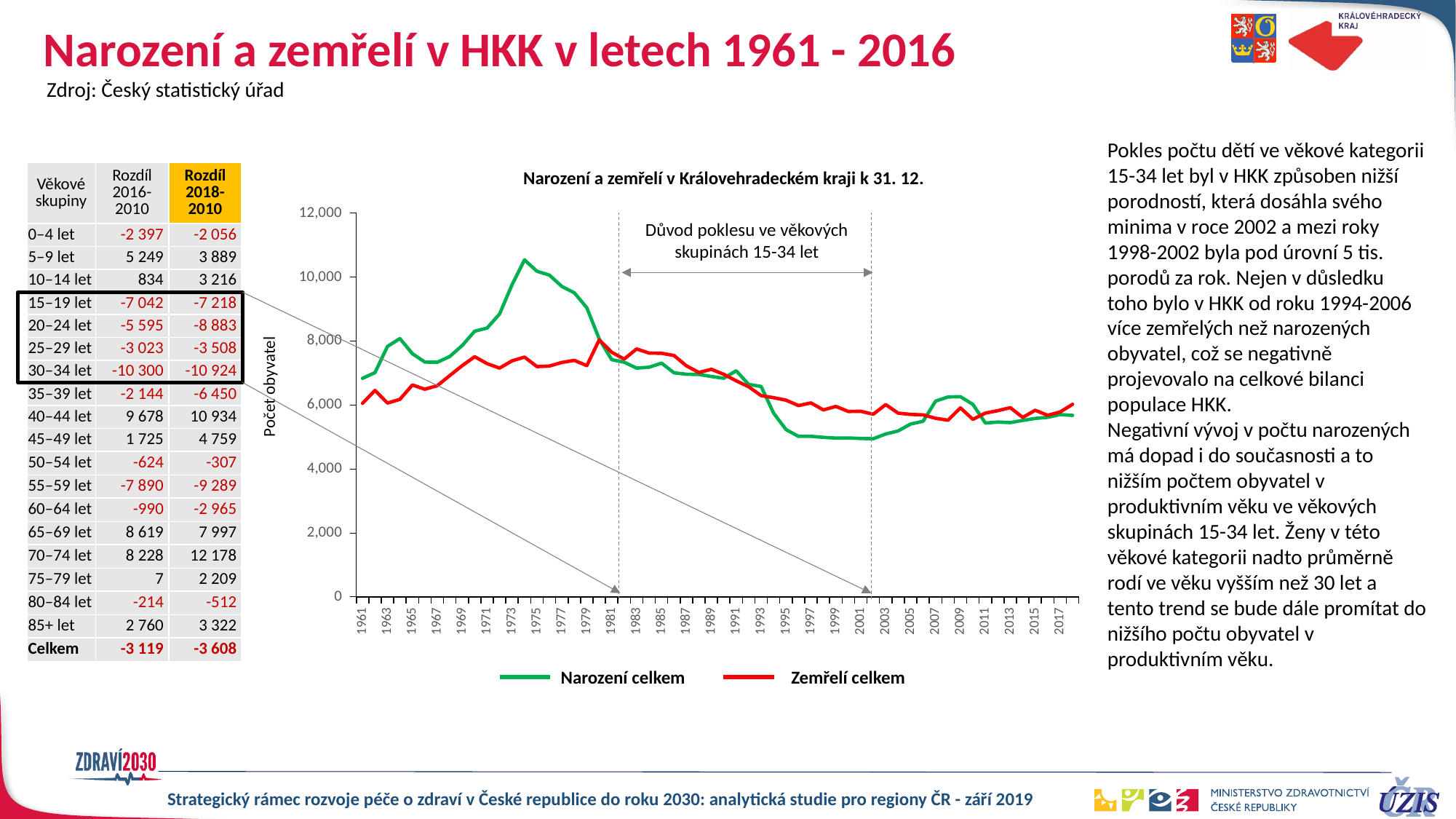
In 1997, which series has the larger value, Narození celkem or Zemřelí celkem? Zemřelí celkem What is the title of the chart? Narození a zemřelí v Královehradeckém kraji k 31. 12. How many series does the chart legend list? 2 Does the Narození celkem series rise or fall between 1975 and 1997? fall Is the value for Narození celkem in 1973 greater or less than 8,000? greater Which series reaches the highest value anywhere on the chart? Narození celkem In 1975, which series has the larger value, Narození celkem or Zemřelí celkem? Narození celkem Is the value for Zemřelí celkem in 2001 greater or less than 8,000? less Which colour is used for the Narození celkem series? green Is the value for Zemřelí celkem in 1961 greater or less than 8,000? less What kind of chart is shown on the slide? line chart